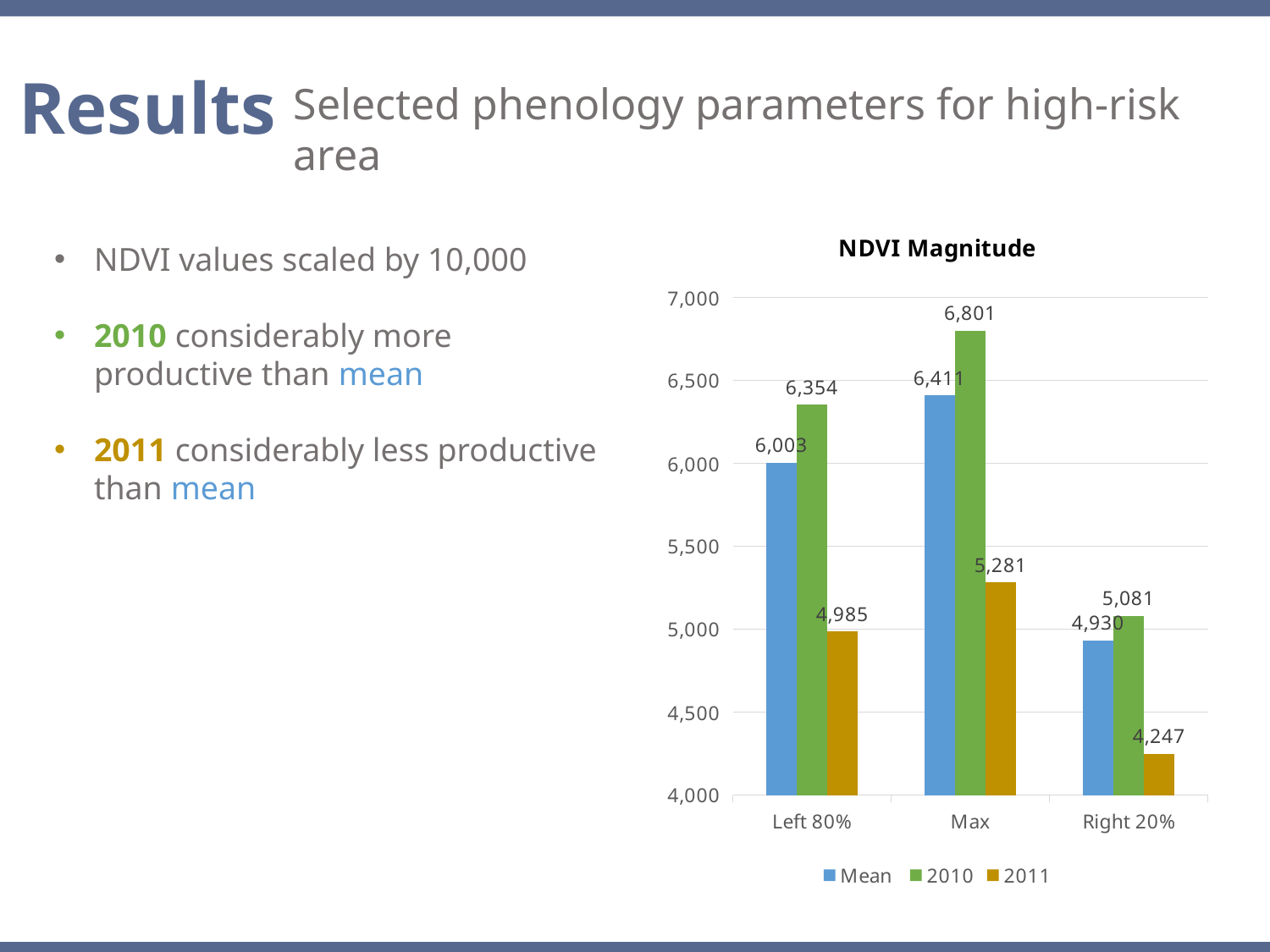
What is the 2011 value for Right 20% in the NDVI Magnitude chart? 4,247 Which is larger for Left 80% in the NDVI Magnitude chart, the Mean value or the 2010 value? 2010 How many categories are shown on the x axis of the NDVI Magnitude chart? 3 What kind of chart is the NDVI Magnitude chart? Bar chart What colour represents the 2011 series in the NDVI Magnitude chart? Gold How many series does the legend of the NDVI Magnitude chart list? 3 What is the difference between the 2010 and 2011 values for Max in the NDVI Magnitude chart? 1,520 What is the 2010 value for Max in the NDVI Magnitude chart? 6,801 Which category has the highest 2011 value in the NDVI Magnitude chart? Max Which category has the lowest Mean value in the NDVI Magnitude chart? Right 20% Is the 2011 value for Left 80% greater or less than 5,000 in the NDVI Magnitude chart? less What is the Mean value for Left 80% in the NDVI Magnitude chart? 6,003